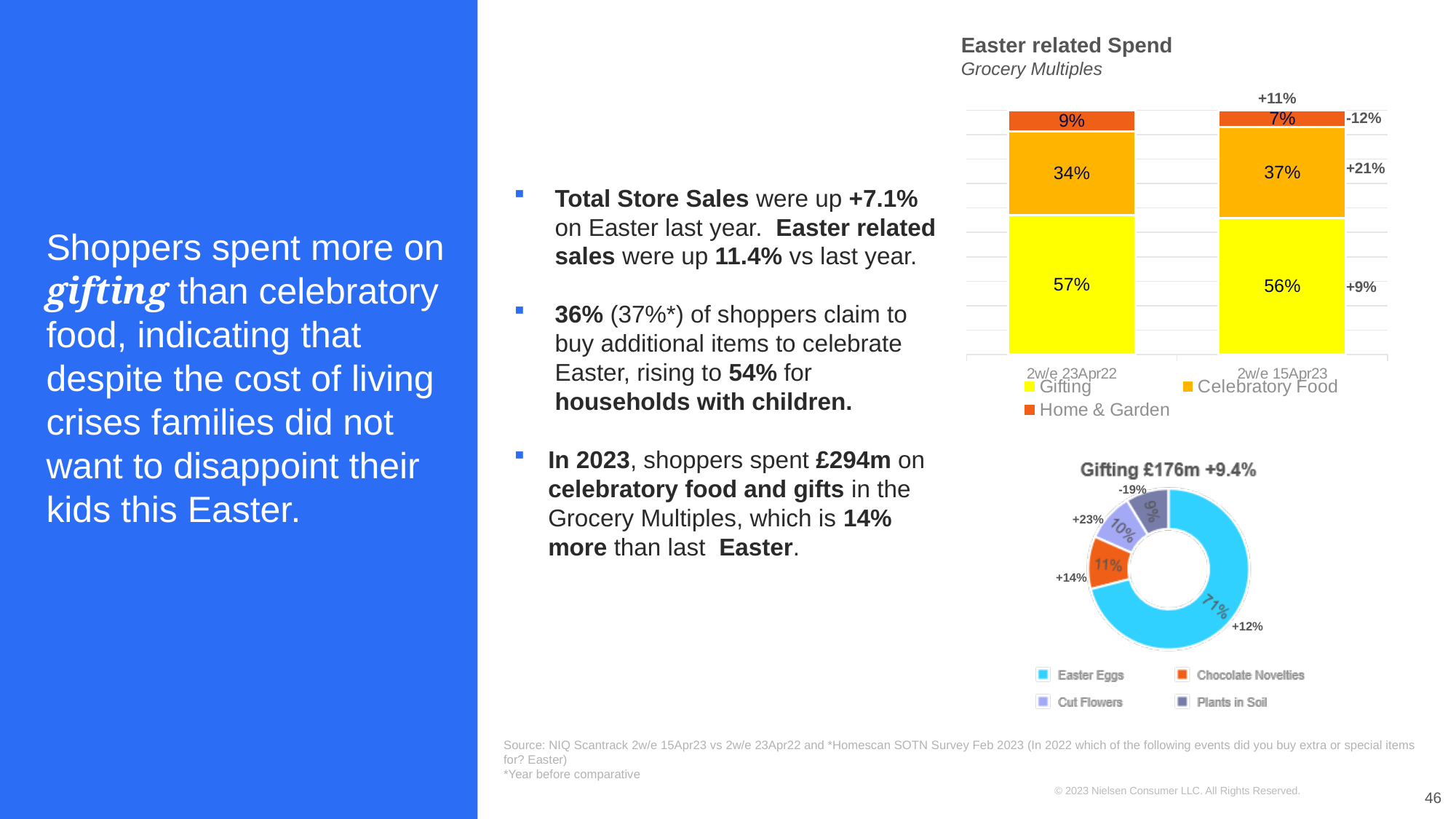
In the 'Easter related Spend' chart, how many series does the legend list? 3 In the 'Easter related Spend' chart, what share of spend was Gifting in 2w/e 15Apr23? 56% In the 'Easter related Spend' chart, by how many percentage points did the Celebratory Food share change from 2w/e 23Apr22 to 2w/e 15Apr23? 3 percentage points In the 'Gifting £176m +9.4%' donut chart, which category has the smallest share? Plants in Soil In the 'Gifting £176m +9.4%' donut chart, what share do Easter Eggs account for? 71% In the 'Easter related Spend' chart, which segment is the largest in the 2w/e 23Apr22 bar? Gifting In the 'Easter related Spend' chart, which segment is the smallest in the 2w/e 15Apr23 bar? Home & Garden In the 'Gifting £176m +9.4%' donut chart, how many categories does the legend list? 4 In the 'Easter related Spend' chart, what growth figure is shown next to the Celebratory Food segment for 2w/e 15Apr23? +21% In the 'Easter related Spend' chart, what share of spend was Celebratory Food in 2w/e 23Apr22? 34% What type of chart is the 'Easter related Spend' chart? Stacked bar chart In the 'Easter related Spend' chart, what share of spend was Home & Garden in 2w/e 15Apr23? 7%